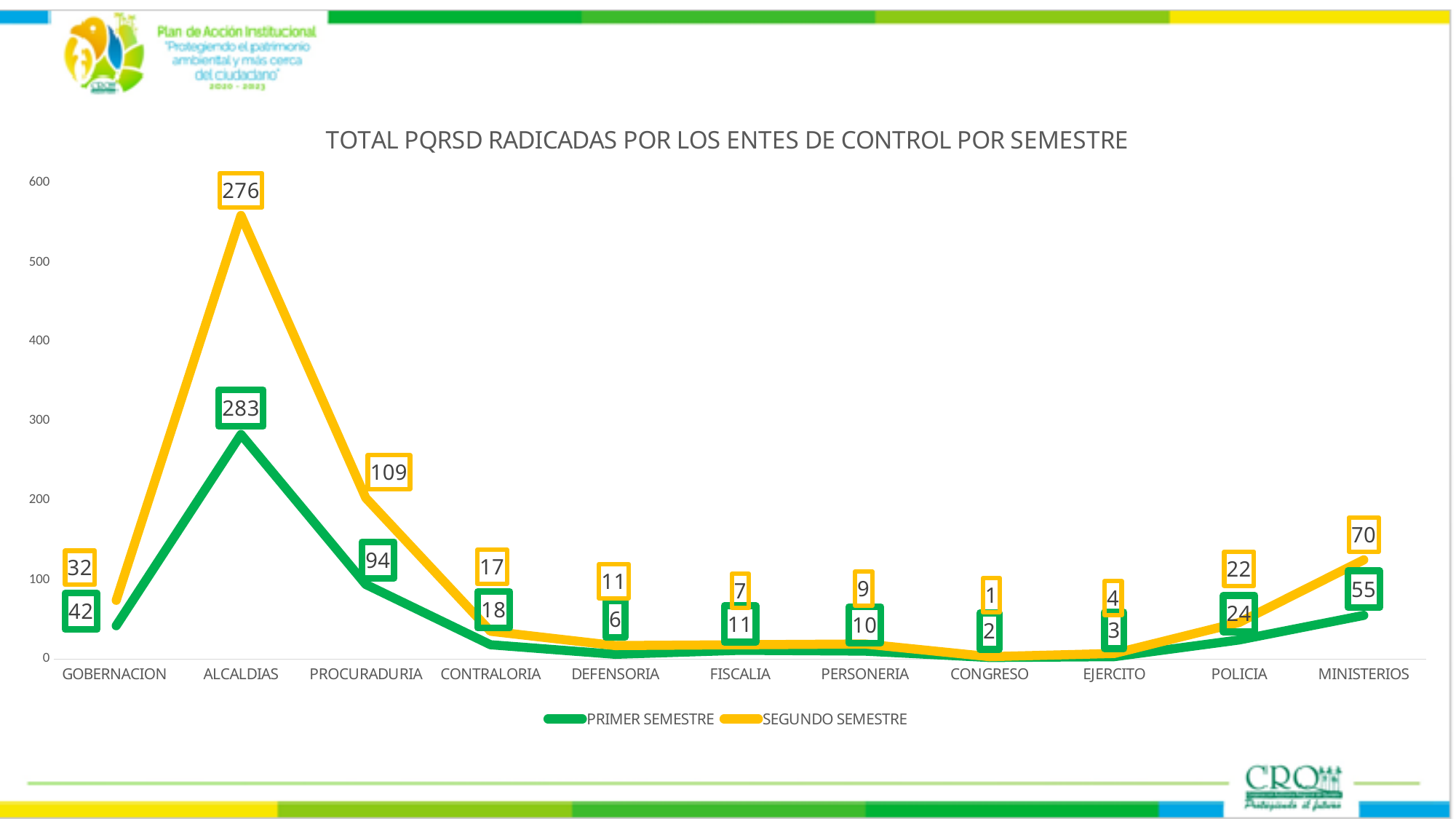
What is the difference between the SEGUNDO SEMESTRE and PRIMER SEMESTRE values for PROCURADURIA? 15 Which category has the highest SEGUNDO SEMESTRE value? ALCALDIAS What is the SEGUNDO SEMESTRE value for MINISTERIOS? 70 What is the title of the chart? TOTAL PQRSD RADICADAS POR LOS ENTES DE CONTROL POR SEMESTRE How many series does the legend list? 2 What kind of chart is shown on the slide? line chart What is the PRIMER SEMESTRE value for CONGRESO? 2 How many categories are shown on the x axis? 11 Which is larger for GOBERNACION, the PRIMER SEMESTRE value or the SEGUNDO SEMESTRE value? PRIMER SEMESTRE Which category has the lowest SEGUNDO SEMESTRE value? CONGRESO What is the PRIMER SEMESTRE value for PROCURADURIA? 94 Which series is drawn in yellow? SEGUNDO SEMESTRE